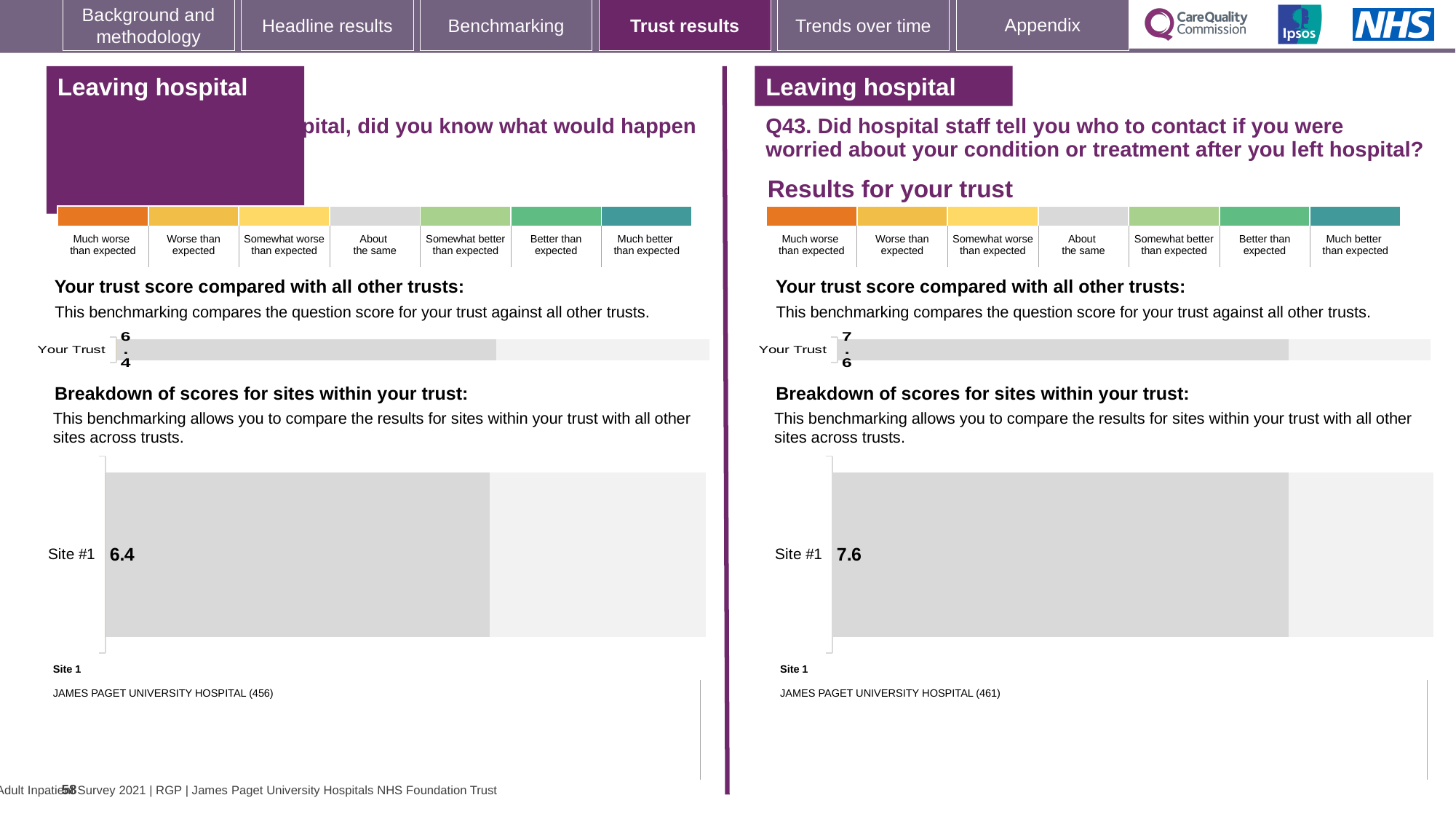
Which site name is listed under Site 1 on the right half of the slide? JAMES PAGET UNIVERSITY HOSPITAL (461) How many sites are plotted in the 'Breakdown of scores for sites within your trust' chart on the left half of the slide? 1 On the left half of the slide, what is the value shown for Your Trust in the 'Your trust score compared with all other trusts' chart? 6.4 How many bars are plotted in the 'Your trust score compared with all other trusts' chart on the right half of the slide? 1 On the right half of the slide (Q43), what score is shown for Site #1 in the 'Breakdown of scores for sites within your trust' chart? 7.6 Which is larger: the Site #1 score in the left-hand breakdown chart or the Site #1 score in the right-hand (Q43) breakdown chart? The right-hand (Q43) chart On the right half of the slide (Q43), what is the value shown for Your Trust in the 'Your trust score compared with all other trusts' chart? 7.6 How many benchmark categories are shown in the colour scale above the charts on the right half of the slide? 7 On the left half of the slide, what score is shown for Site #1 in the 'Breakdown of scores for sites within your trust' chart? 6.4 What type of chart is used to show the Site #1 score in the 'Breakdown of scores for sites within your trust' section on the right half of the slide? Bar chart What is the difference between the Site #1 score in the right-hand (Q43) breakdown chart and the Site #1 score in the left-hand breakdown chart? 1.2